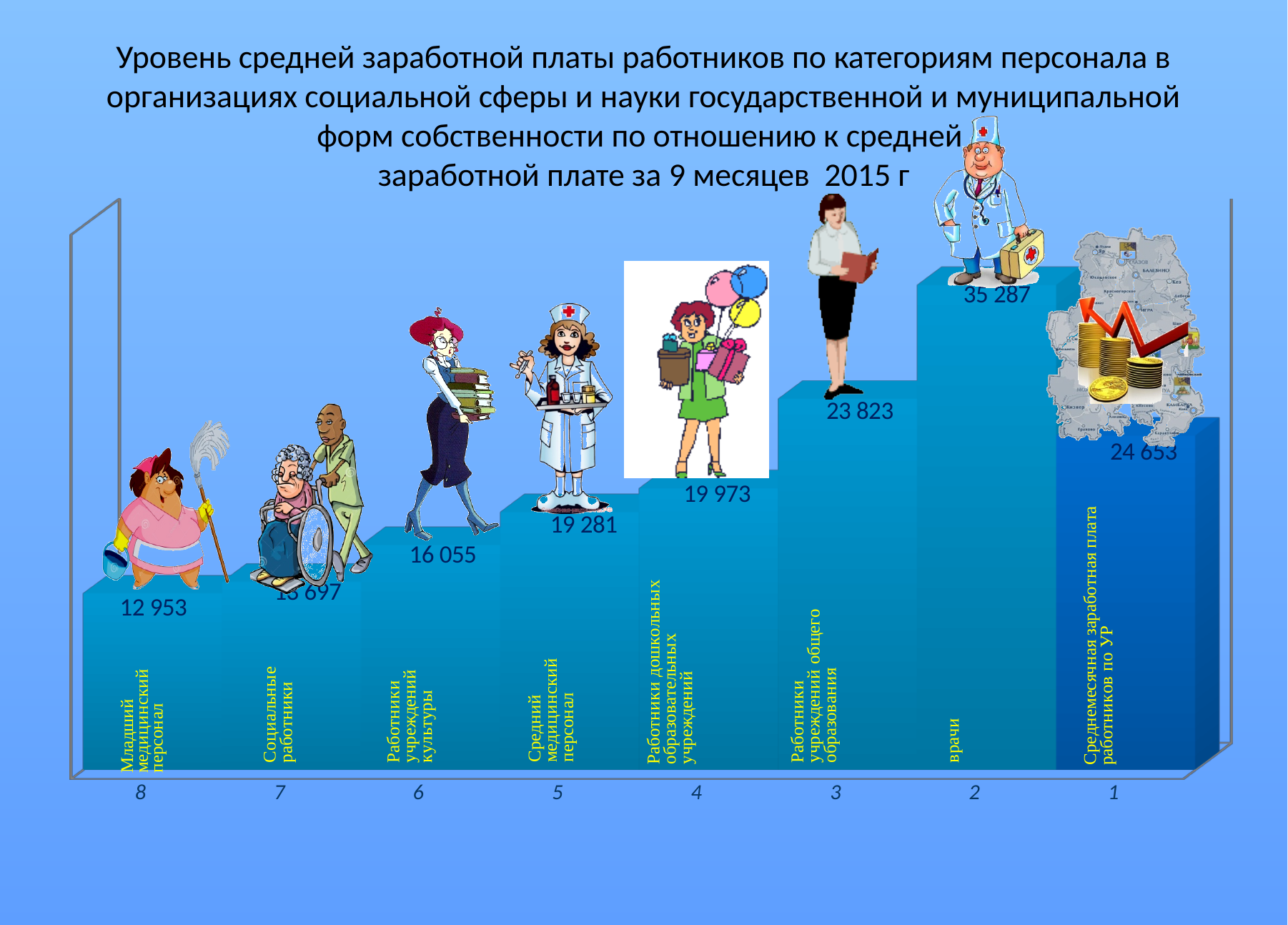
What is the value for Работники дошкольных образовательных учреждений? 19 973 What is the value for Работники учреждений общего образования? 23 823 Which category has the lowest value? Младший медицинский персонал Which category has the highest value? врачи What is the value for врачи? 35 287 What is the value for Средний медицинский персонал? 19 281 What is the difference between the value for врачи and the value for Работники учреждений общего образования? 11 464 What is the value for Младший медицинский персонал? 12 953 Which is larger: the value for Работники учреждений общего образования or the value for Среднемесячная заработная плата работников по УР? Среднемесячная заработная плата работников по УР What is the value for Среднемесячная заработная плата работников по УР? 24 653 What is the value for Работники учреждений культуры? 16 055 What kind of chart is shown on the slide? bar chart